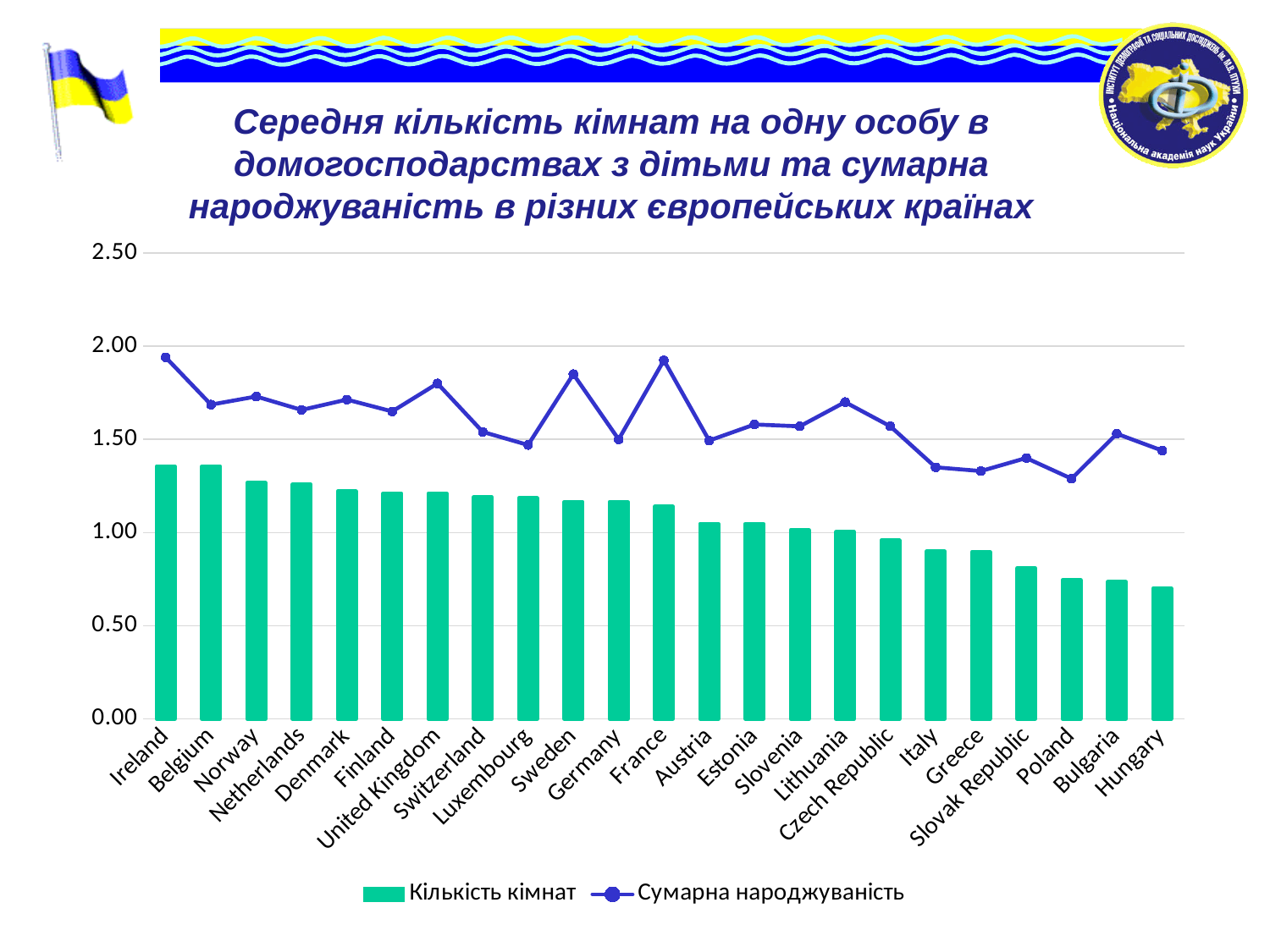
Is the Сумарна народжуваність value for Poland greater or less than 1.50? less Which has the larger Сумарна народжуваність value, Sweden or Austria? Sweden Is the Кількість кімнат value for Hungary greater or less than 1.00? less How many series does the legend list? 2 Is the Кількість кімнат value for Ireland greater or less than 1.00? greater Which series is drawn as a line with markers? Сумарна народжуваність How many countries are shown on the x axis? 23 Do the bar values for Кількість кімнат rise or fall from Ireland to Hungary? fall Which series is drawn as bars? Кількість кімнат Which has the larger Кількість кімнат value, Ireland or Hungary? Ireland What kind of chart is shown on the slide? A combined bar and line chart